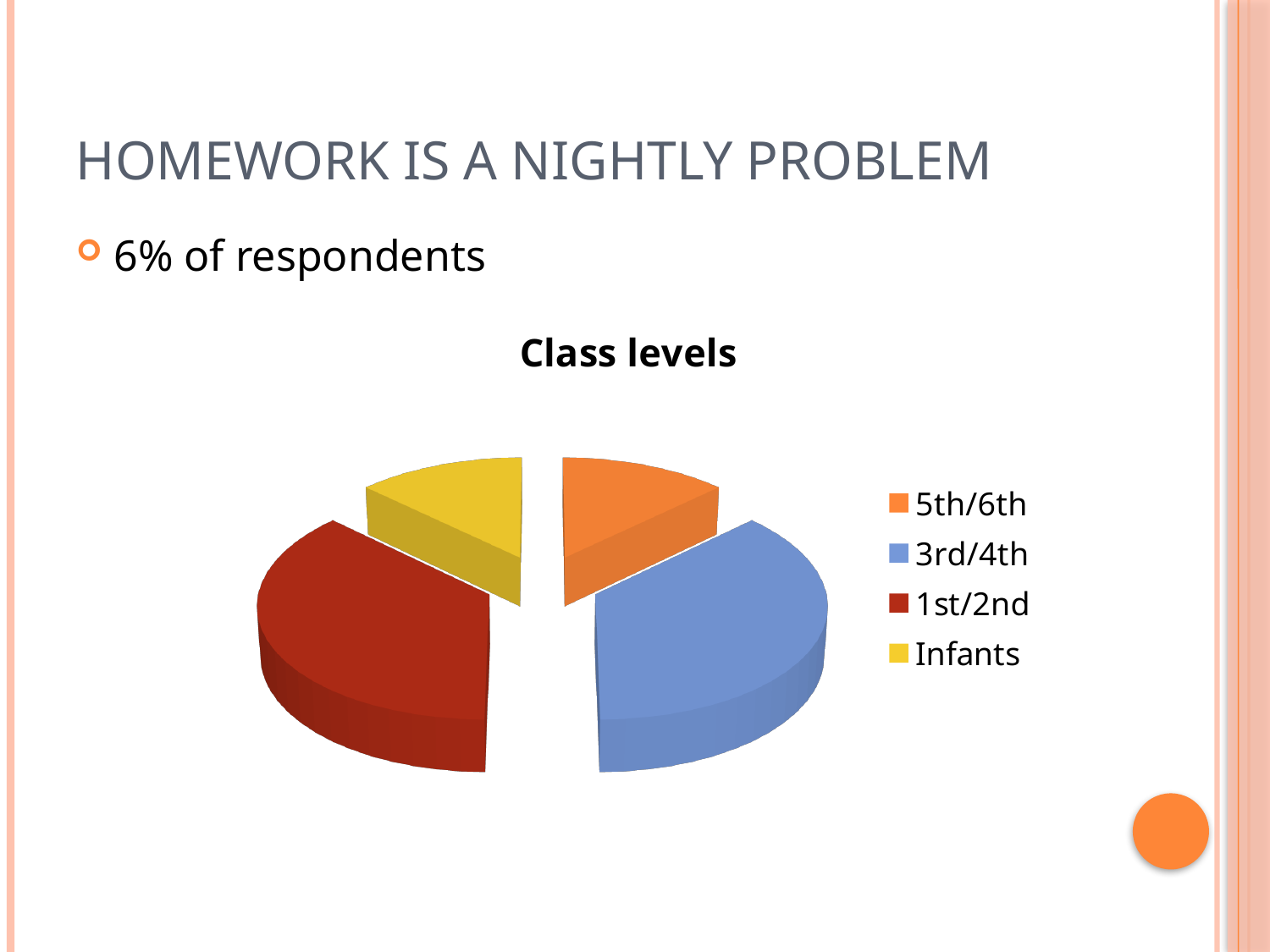
Which slice is larger in the Class levels chart, 3rd/4th or Infants? 3rd/4th What kind of chart is shown on the slide? pie chart Which slice is larger in the Class levels chart, 3rd/4th or 5th/6th? 3rd/4th How many slices does the Class levels pie chart have? 4 What colour is the Infants slice in the Class levels pie chart? yellow How many entries does the legend of the Class levels chart list? 4 What is the title of the pie chart on the slide? Class levels Which slice is larger in the Class levels chart, 1st/2nd or Infants? 1st/2nd